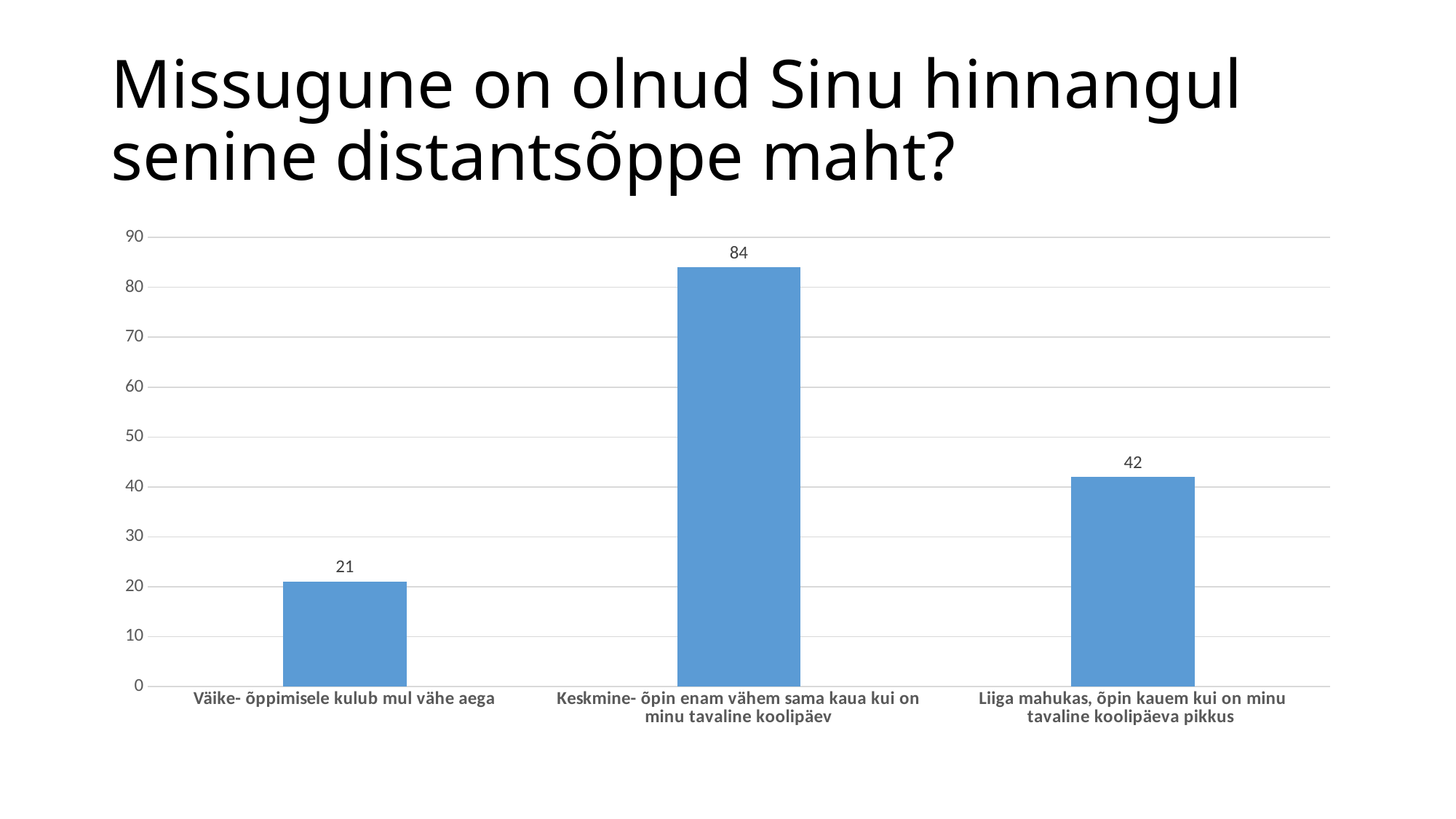
How many categories are shown on the x axis? 3 What is the value for the category "Keskmine- õpin enam vähem sama kaua kui on minu tavaline koolipäev"? 84 Which is larger, the value for "Väike- õppimisele kulub mul vähe aega" or the value for "Liiga mahukas, õpin kauem kui on minu tavaline koolipäeva pikkus"? Liiga mahukas, õpin kauem kui on minu tavaline koolipäeva pikkus What is the difference between the values for "Liiga mahukas" and "Väike"? 21 What is the difference between the values for "Keskmine" and "Liiga mahukas"? 42 Is the value for "Keskmine- õpin enam vähem sama kaua kui on minu tavaline koolipäev" greater or less than 80? greater Which category has the highest value? Keskmine- õpin enam vähem sama kaua kui on minu tavaline koolipäev What is the value for the category "Liiga mahukas, õpin kauem kui on minu tavaline koolipäeva pikkus"? 42 What is the title of the slide? Missugune on olnud Sinu hinnangul senine distantsõppe maht? What kind of chart is shown on the slide? bar chart Which category has the lowest value? Väike- õppimisele kulub mul vähe aega What is the value for the category "Väike- õppimisele kulub mul vähe aega"? 21